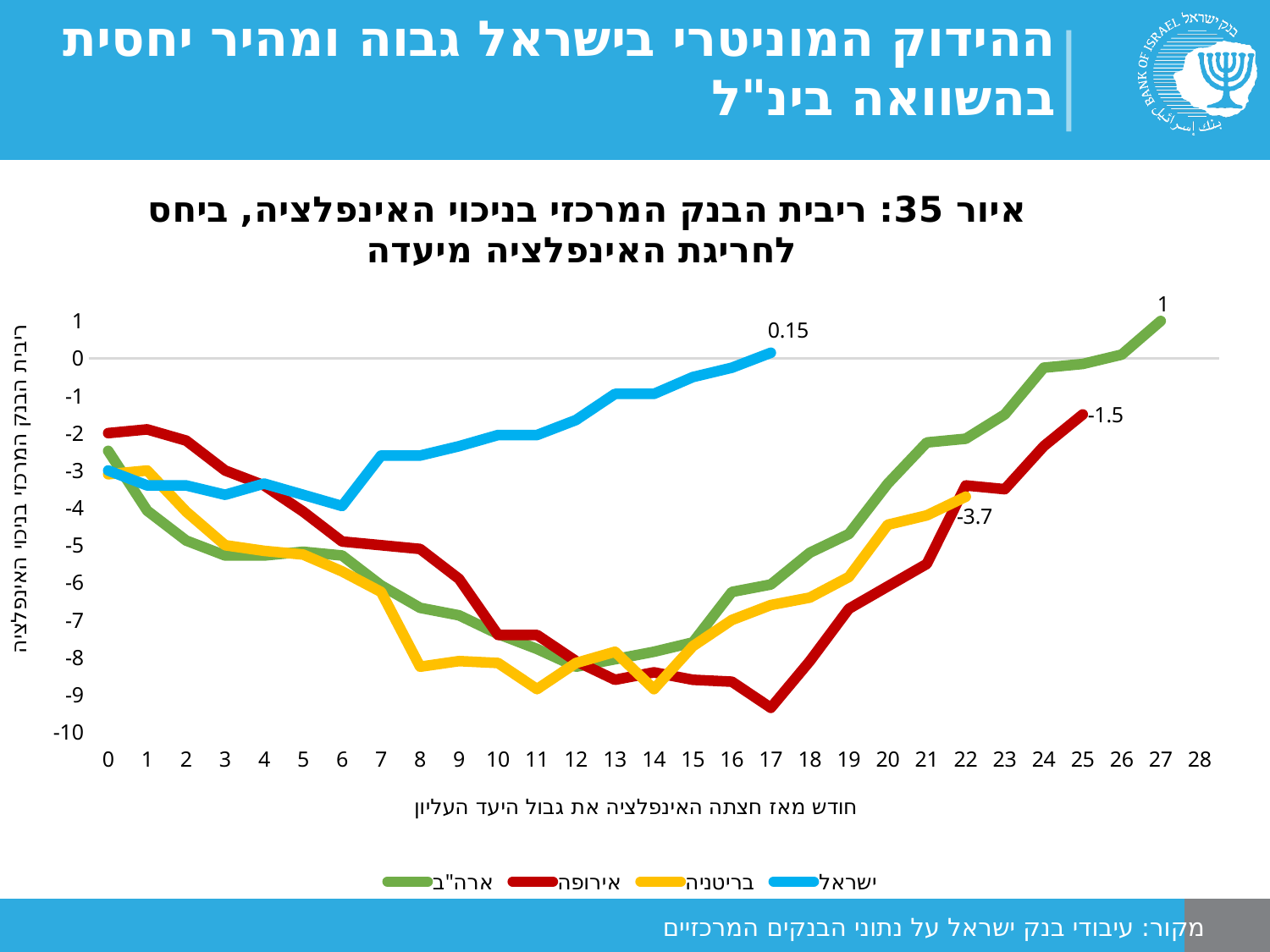
What is the labelled final value of the ארה"ב (USA) line? 1 How many series does the legend list? 4 Which is larger, the final labelled value of ארה"ב or of אירופה? ארה"ב What is the x-axis title of the chart? חודש מאז חצתה האינפלציה את גבול היעד העליון What is the labelled final value of the אירופה (Europe) line? -1.5 What is the labelled final value of the ישראל (Israel) line? 0.15 What kind of chart is shown on the slide? line chart What is the labelled final value of the בריטניה (Britain) line? -3.7 What is the difference between the final labelled values of ארה"ב (1) and אירופה (-1.5)? 2.5 Which series ends at the highest labelled value? ארה"ב Is the value for ישראל at month 6 greater or less than -3? less Does the ישראל line rise or fall between month 7 and month 17? rise